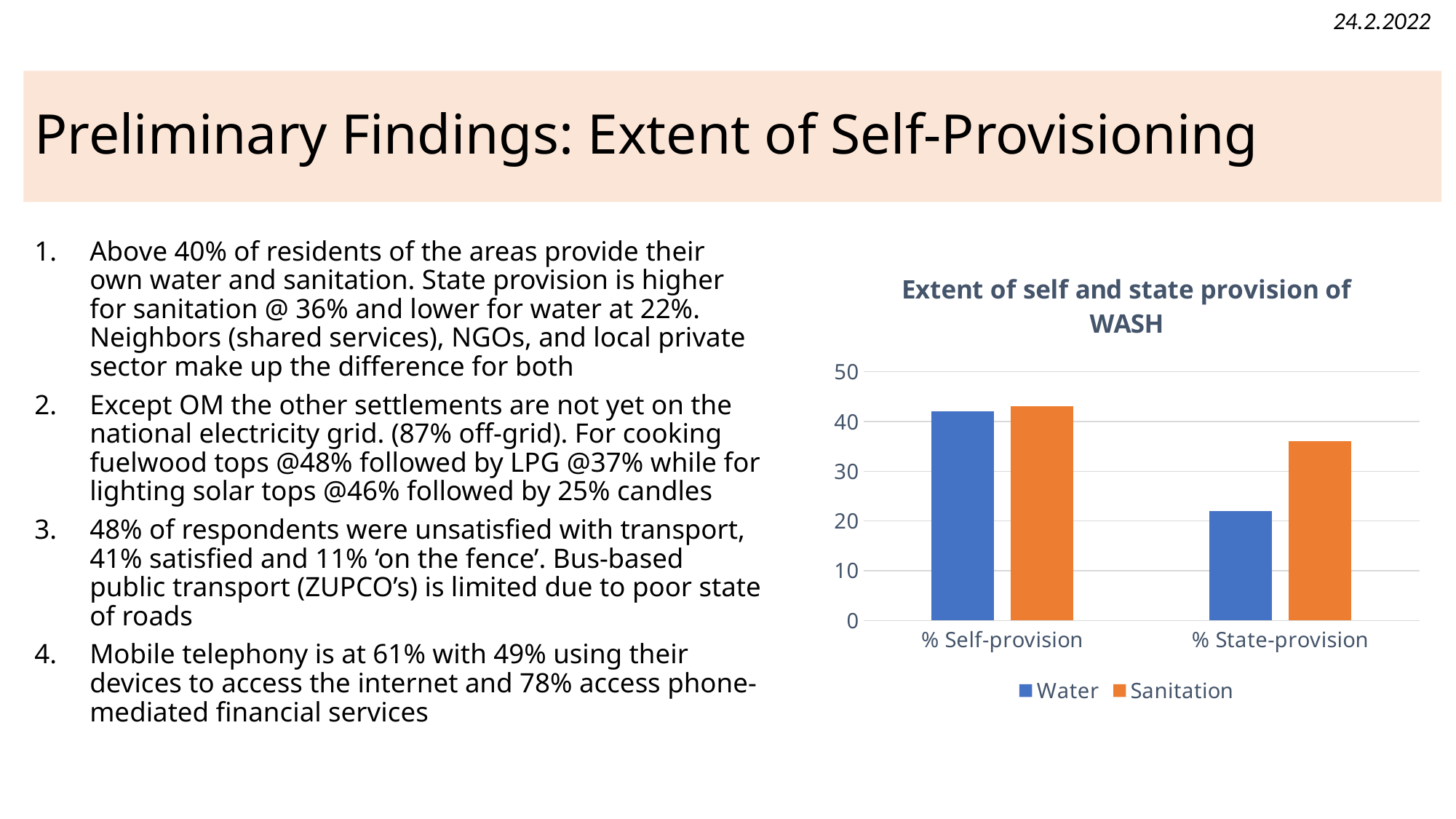
What is the title of the chart? Extent of self and state provision of WASH Which series is shown in orange in the chart? Sanitation How many categories are shown on the x axis of the chart? 2 Is the value for Water under % Self-provision greater or less than 40? greater Under % State-provision, which is larger, Water or Sanitation? Sanitation How many series does the chart legend list? 2 Is the value for Sanitation under % Self-provision greater or less than 50? less Is the value for Water under % State-provision greater or less than 30? less Which bar in the chart has the lowest value? Water under % State-provision What type of chart is shown on the slide? bar chart